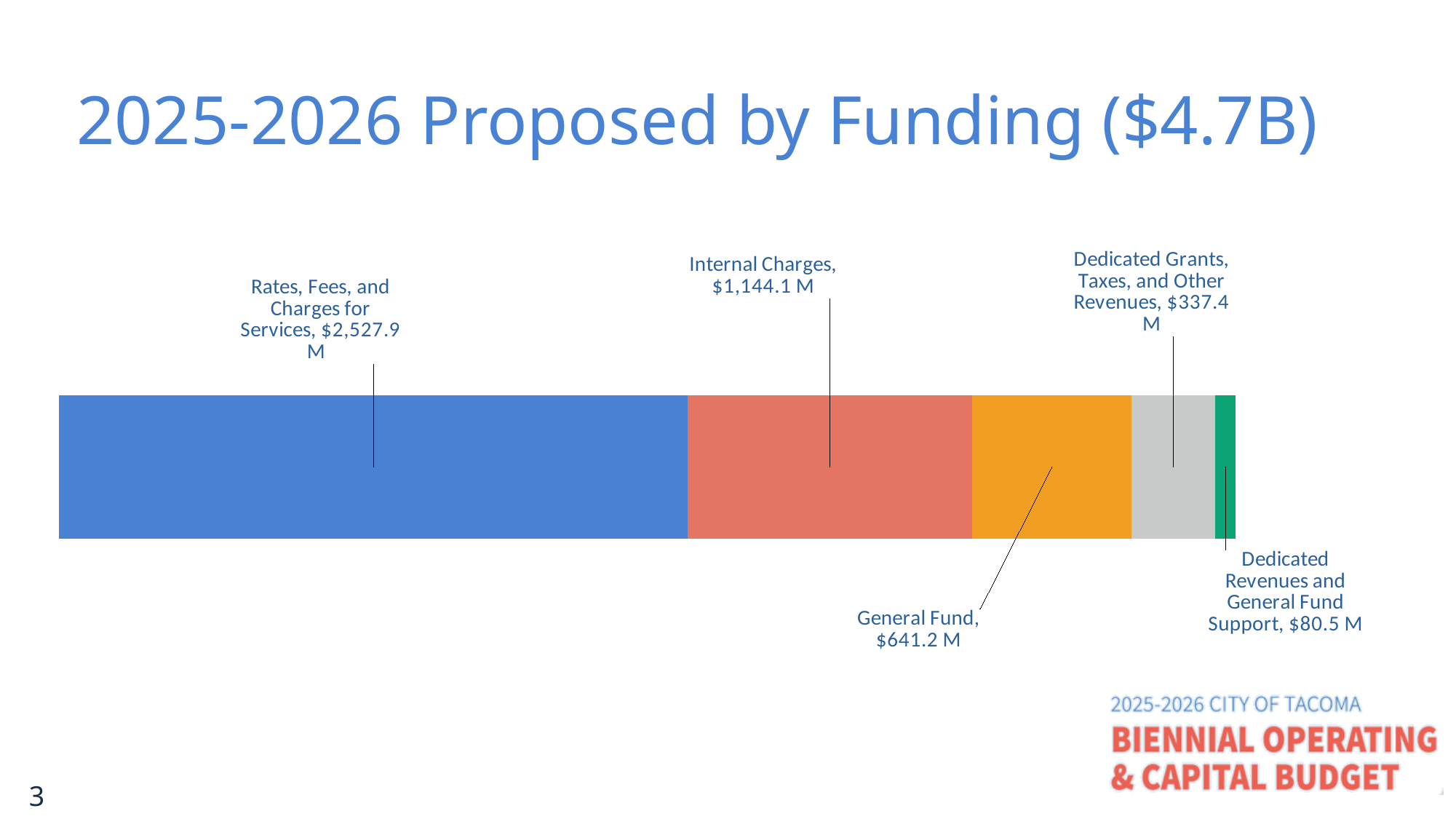
What is the value for General Fund? $641.2 M How many funding categories are shown in the bar? 5 Which funding category has the smallest value? Dedicated Revenues and General Fund Support What kind of chart is shown on the slide? Stacked bar chart What is the title of the slide? 2025-2026 Proposed by Funding ($4.7B) Which is larger, General Fund or Dedicated Grants, Taxes, and Other Revenues? General Fund Which funding category has the largest value? Rates, Fees, and Charges for Services What is the value for Internal Charges? $1,144.1 M What is the value for Dedicated Grants, Taxes, and Other Revenues? $337.4 M What is the difference between Rates, Fees, and Charges for Services and Internal Charges? $1,383.8 M What is the value for Dedicated Revenues and General Fund Support? $80.5 M What is the value for Rates, Fees, and Charges for Services? $2,527.9 M